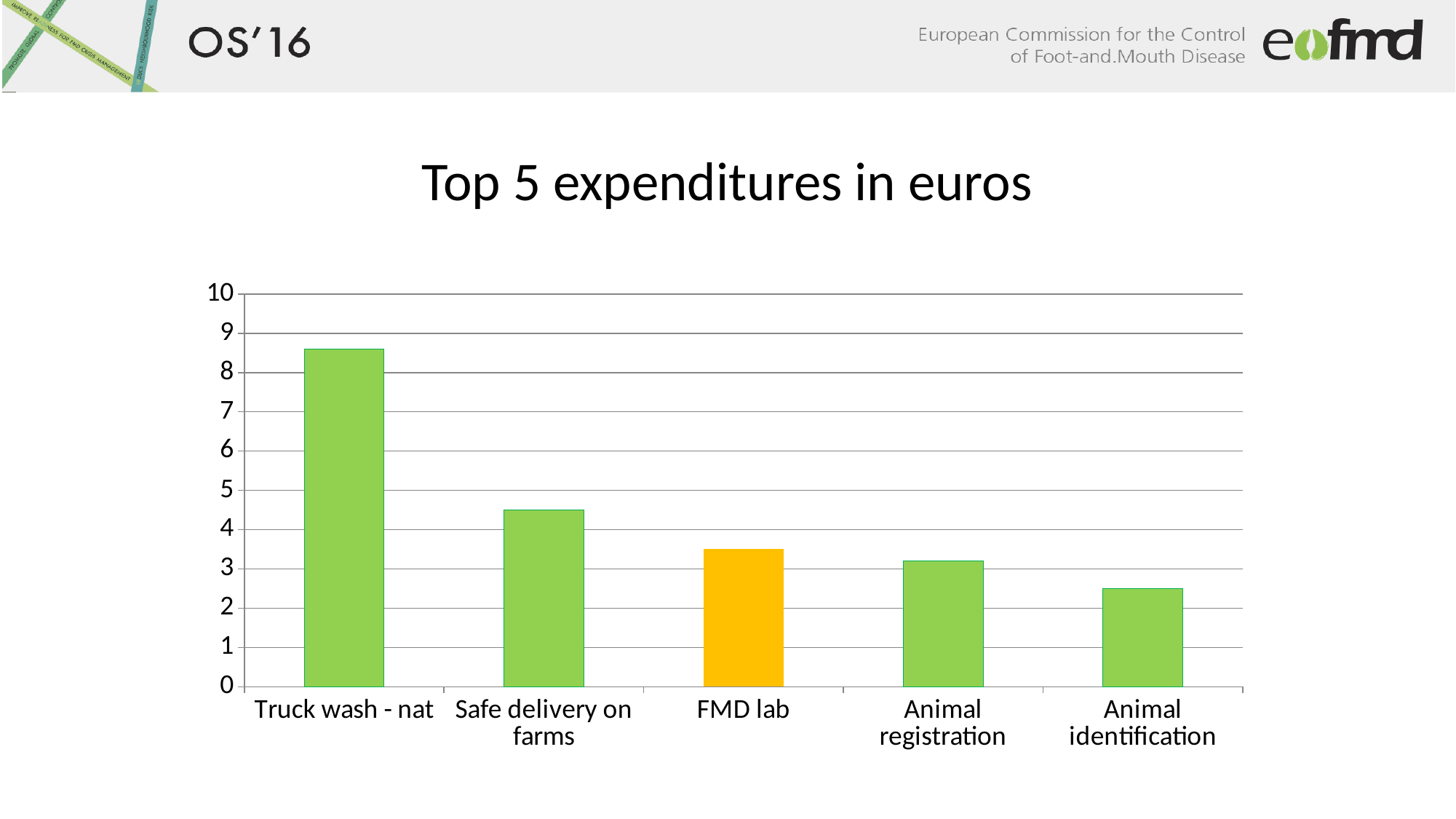
Is the value for Safe delivery on farms greater or less than 4? greater Which is larger, the value for Safe delivery on farms or the value for FMD lab? Safe delivery on farms Which category has the highest expenditure? Truck wash - nat Which category's bar is coloured differently (orange) from the other green bars? FMD lab Is the value for FMD lab greater or less than 3? greater Is the value for Truck wash - nat greater or less than 8? greater What is the title of the chart? Top 5 expenditures in euros Do the values rise or fall from left to right along the x axis? fall How many categories are plotted in the chart? 5 Which category has the lowest expenditure? Animal identification What kind of chart is shown on the slide? bar chart